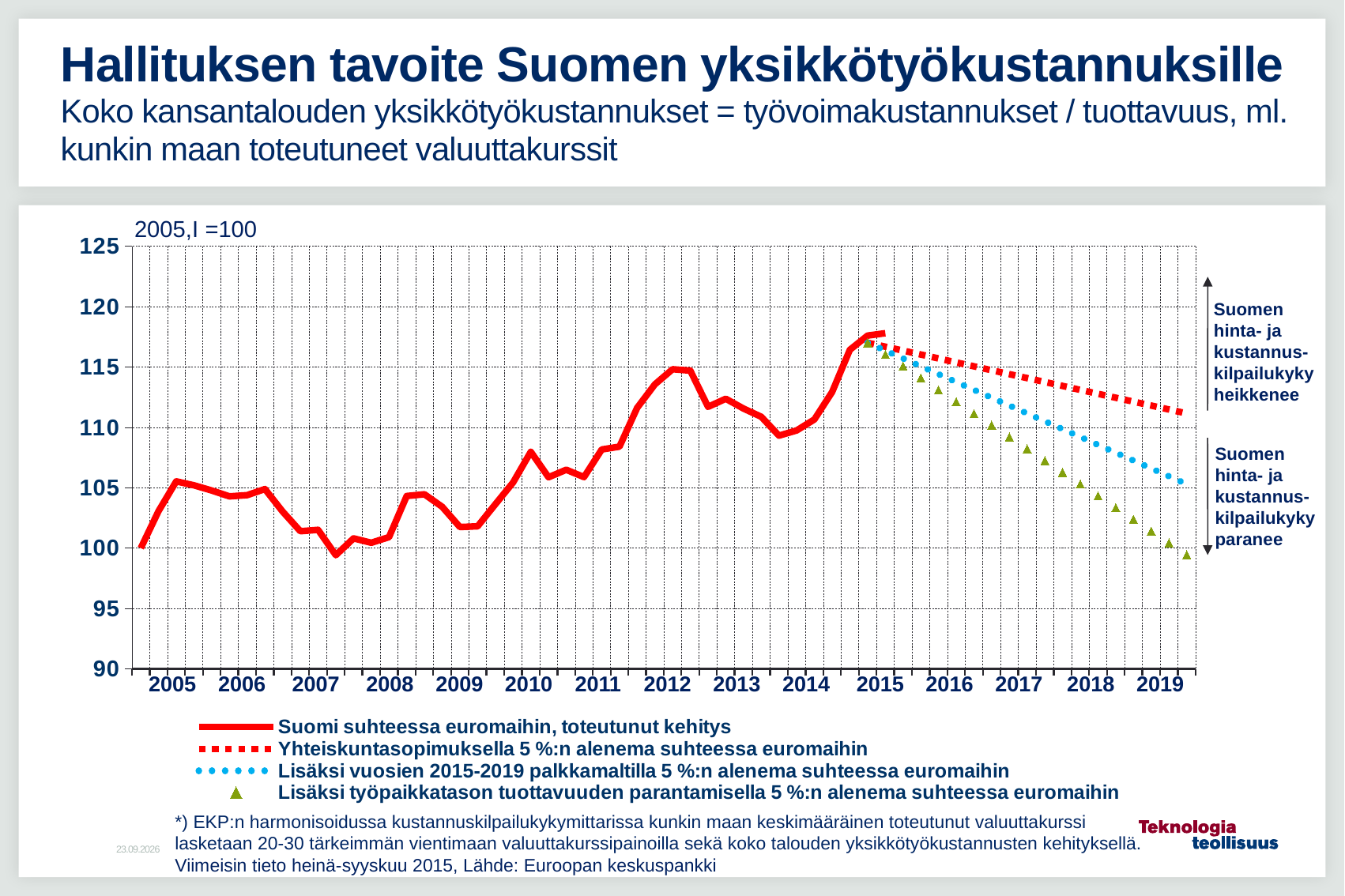
Is the peak value of the solid red line around 2015 greater or less than 115? greater Is the value of the blue dotted line at the end of 2019 greater or less than 110? less Do the projected series rise or fall from 2015 to 2019? fall Is the value of the red dotted line at the end of 2019 greater or less than 110? greater What kind of chart is shown on the slide? line chart Which of the three projected series has the highest value at the end of 2019? Yhteiskuntasopimuksella 5 %:n alenema suhteessa euromaihin (red dotted line) What is the base value of the index, as stated above the chart? 2005,I =100 What is the value of the solid red line at the start of 2005? 100 Which series is drawn as a solid red line according to the legend? Suomi suhteessa euromaihin, toteutunut kehitys How many years are labelled on the x axis? 15 How many series does the legend list? 4